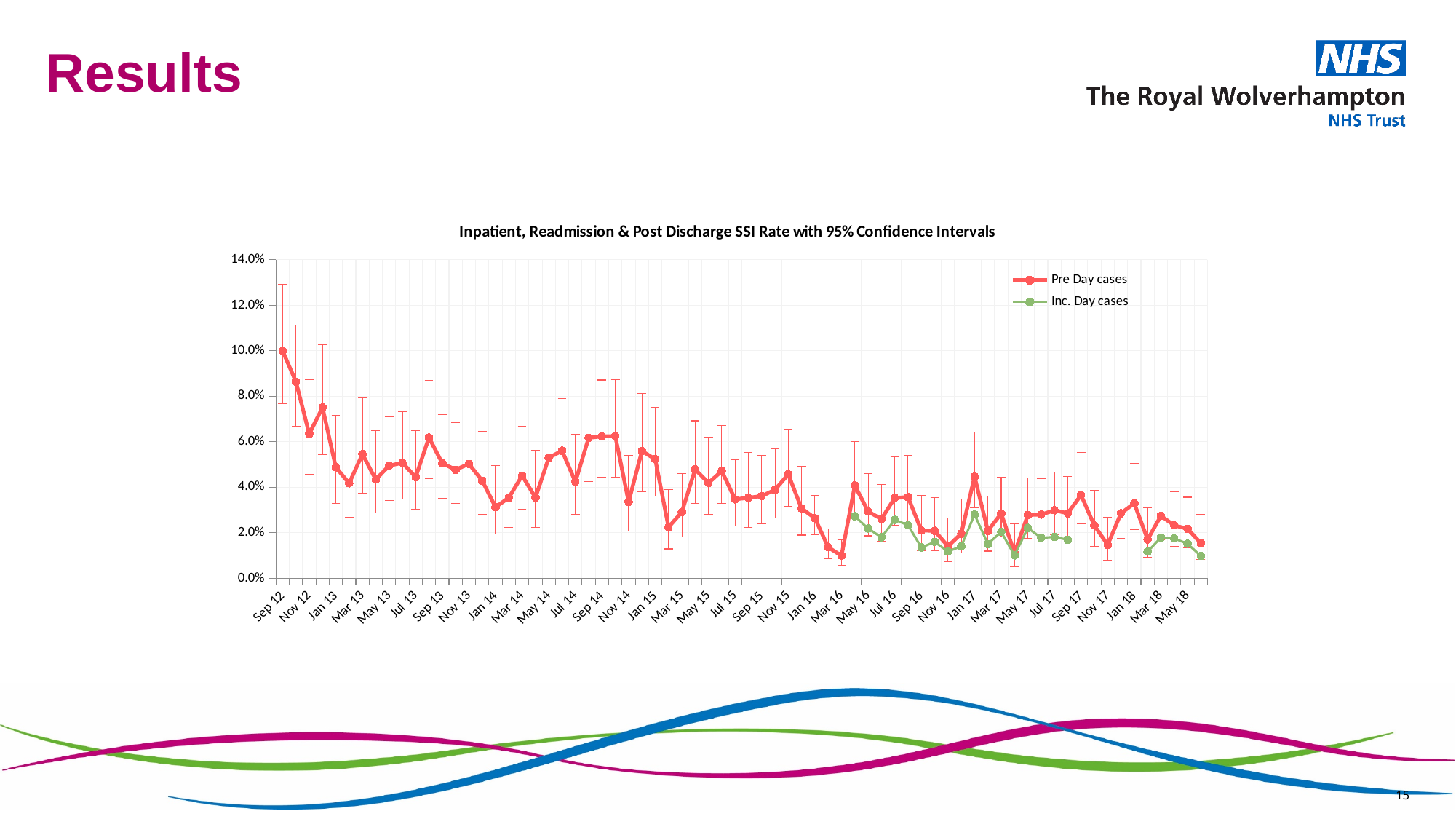
Is the Pre Day cases value at Mar 16 greater or less than 2.0%? less Which is larger, the Pre Day cases value at Sep 12 or at Nov 12? Sep 12 What are the two series named in the legend? Pre Day cases and Inc. Day cases How many series does the legend list? 2 At which x-axis label is the Pre Day cases rate highest? Sep 12 What is the title of the chart? Inpatient, Readmission & Post Discharge SSI Rate with 95% Confidence Intervals Is the Pre Day cases value at Jan 17 greater or less than 4.0%? greater At which x-axis label is the Pre Day cases rate lowest? Mar 16 What kind of chart is shown on the slide? Line chart Overall, does the Pre Day cases rate rise or fall from Sep 12 to May 18? Fall Is the Pre Day cases value at Sep 12 greater or less than 8.0%? greater At Jan 17, which series has the larger value, Pre Day cases or Inc. Day cases? Pre Day cases